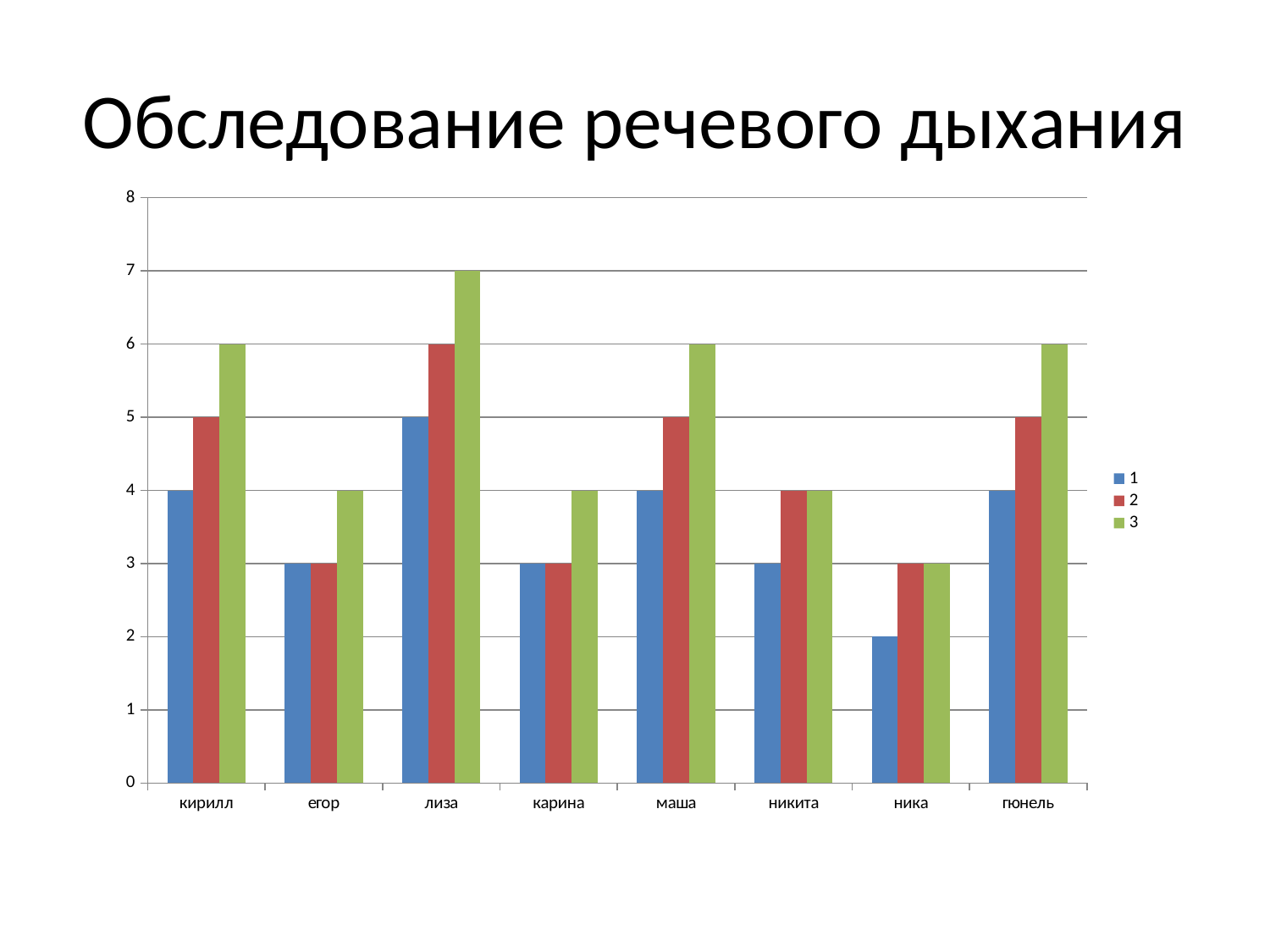
What is the title of the chart on the slide? Обследование речевого дыхания What is the value of series 3 for лиза? 7 Which category has the lowest value for series 1? ника How many categories (names) are shown on the x axis? 8 What kind of chart is shown on the slide? bar chart Is the value of series 3 for гюнель greater or less than 5? greater Which category has the highest value for series 3? лиза What is the difference between the series 3 value and the series 1 value for лиза? 2 What is the value of series 1 for ника? 2 Which is larger: the series 2 value for никита or the series 2 value for карина? никита How many series does the legend list? 3 What is the value of series 2 for кирилл? 5